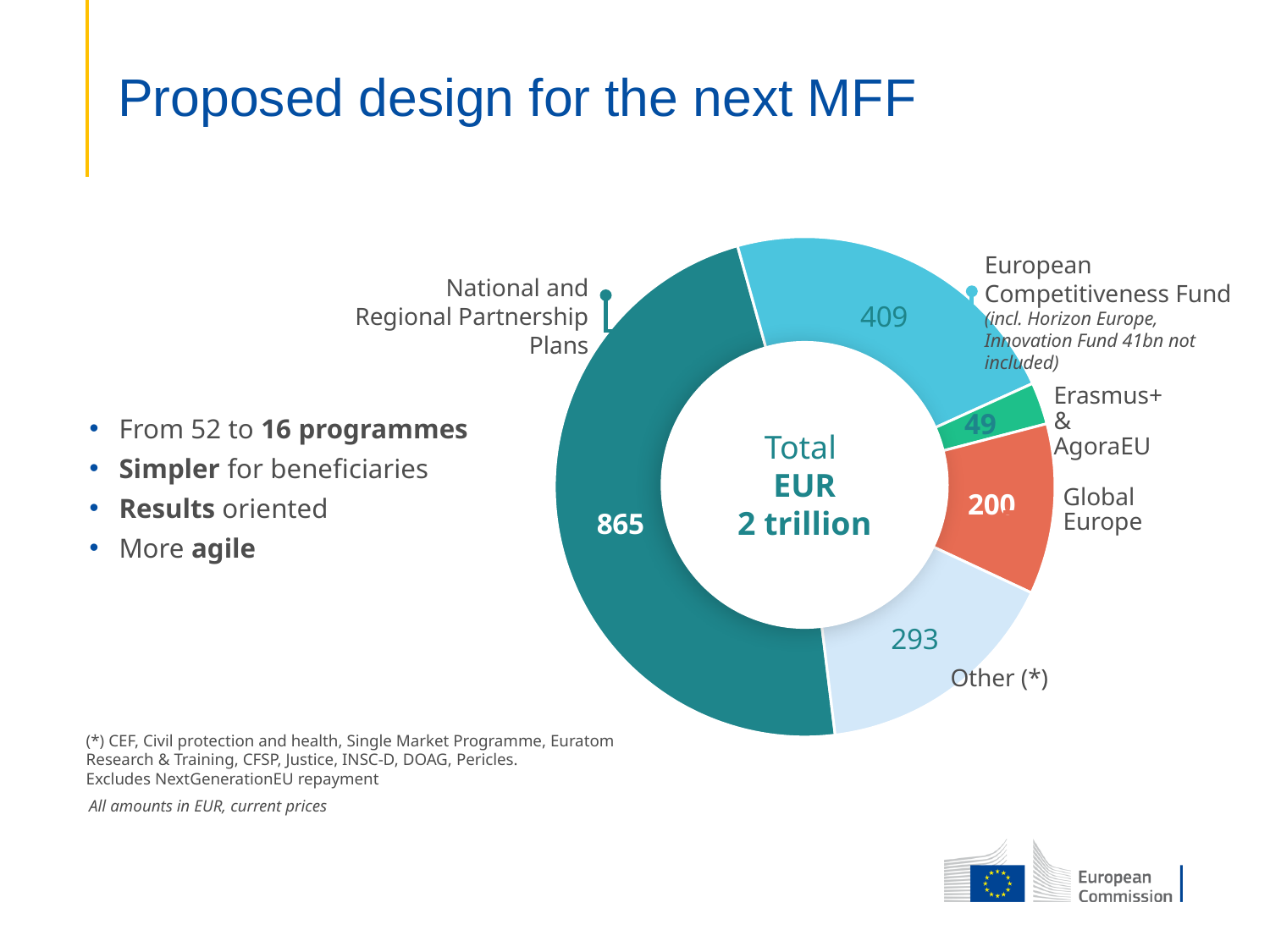
What is the difference between the values for National and Regional Partnership Plans and the European Competitiveness Fund? 456 Which segment of the chart has the largest value? National and Regional Partnership Plans What total is printed in the centre of the chart? Total EUR 2 trillion What value is shown for Erasmus+ & AgoraEU? 49 Which segment of the chart has the smallest value? Erasmus+ & AgoraEU What value is shown for the European Competitiveness Fund segment? 409 How many segments does the chart have? 5 What value is shown for Global Europe? 200 What kind of chart is shown on the slide? Donut (pie) chart What value is shown for the Other (*) segment? 293 Which is larger, the value for Other (*) or the value for Global Europe? Other (*) What value is shown for National and Regional Partnership Plans? 865